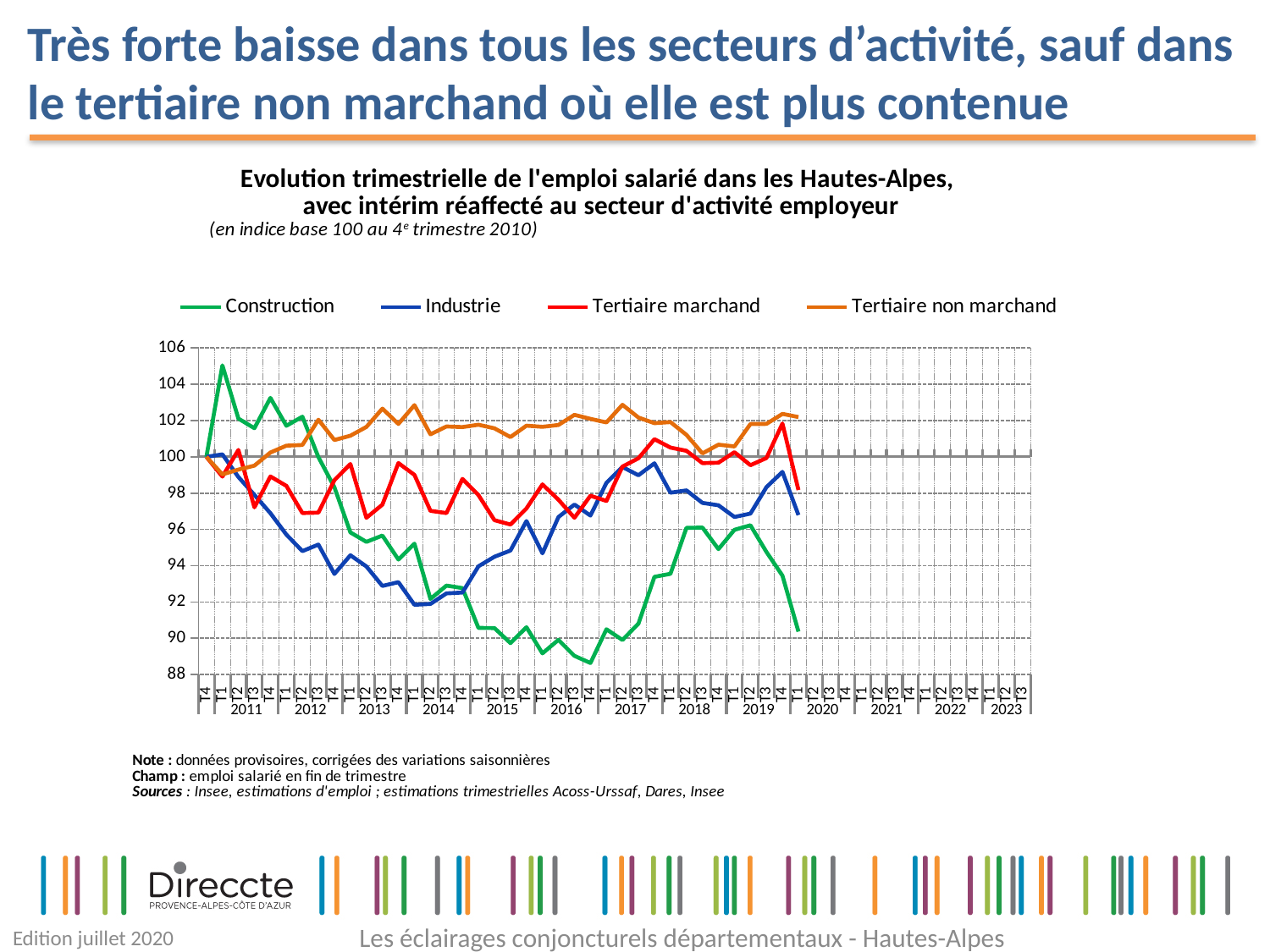
What kind of chart is shown on the slide? line chart Which series has the highest value at T1 2020? Tertiaire non marchand How many series does the legend list? 4 Which series has the lowest value at T1 2020? Construction At T1 2020, which is higher: Industrie or Construction? Industrie What is the base period of the index used in the chart? 4e trimestre 2010 (base 100) Is the value for Construction at T1 2011 greater or less than 104? greater Does the Construction series rise or fall overall from 2011 to T1 2020? fall Is the value for Tertiaire non marchand at T4 2019 greater or less than 100? greater Is the value for Industrie at T1 2020 greater or less than 98? less Which series is plotted in green? Construction